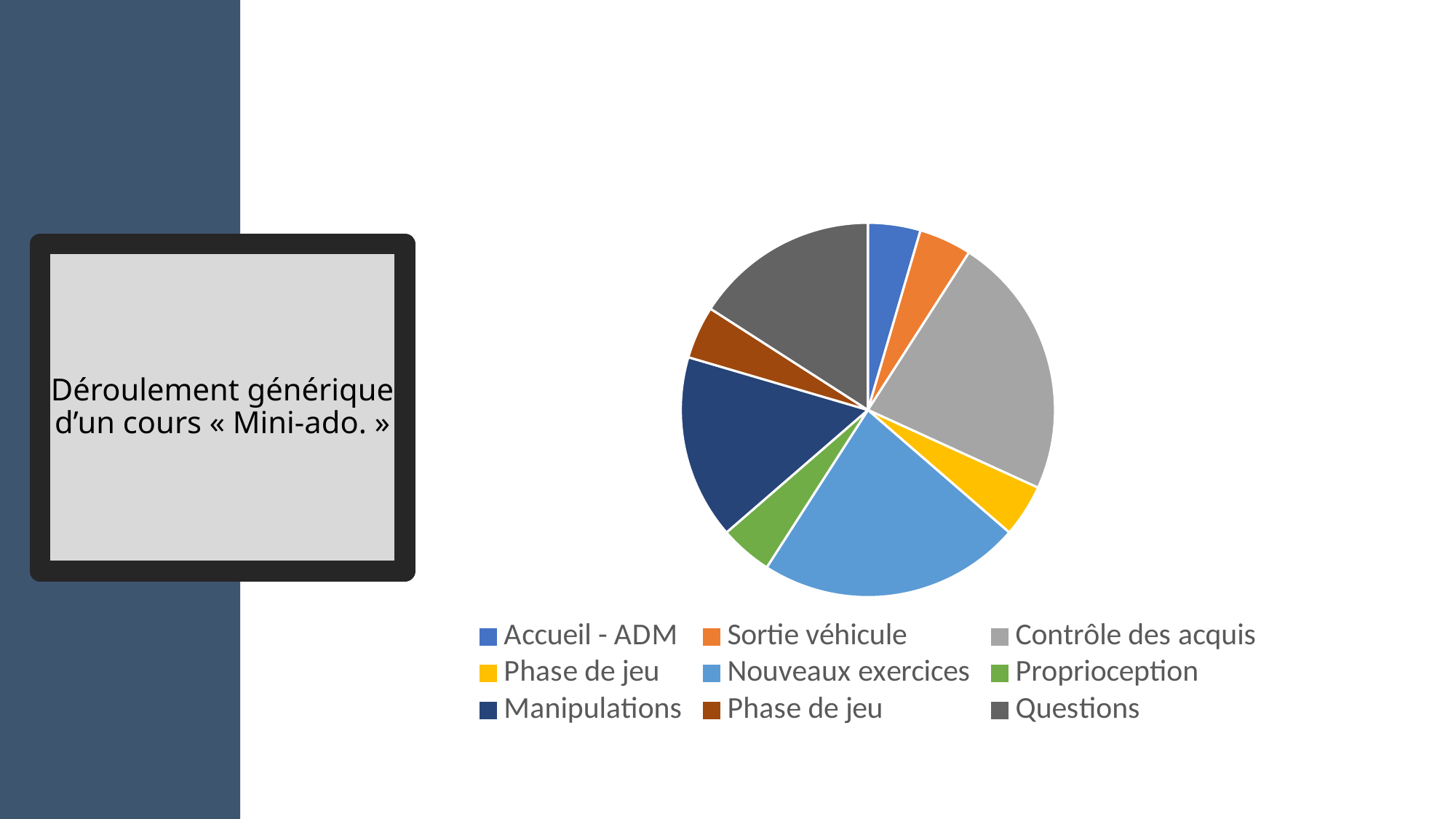
Which is larger in the pie chart, the slice for Questions or the slice for Sortie véhicule? Questions How many slices does the pie chart have? 9 Which legend label appears twice in the pie chart's legend? Phase de jeu Which is larger in the pie chart, the slice for Contrôle des acquis or the slice for Accueil - ADM? Contrôle des acquis Which is larger in the pie chart, the slice for Contrôle des acquis or the slice for Proprioception? Contrôle des acquis How many entries does the legend of the pie chart list? 9 What kind of chart is shown on the slide? pie chart What colour is the Questions slice in the pie chart? dark grey